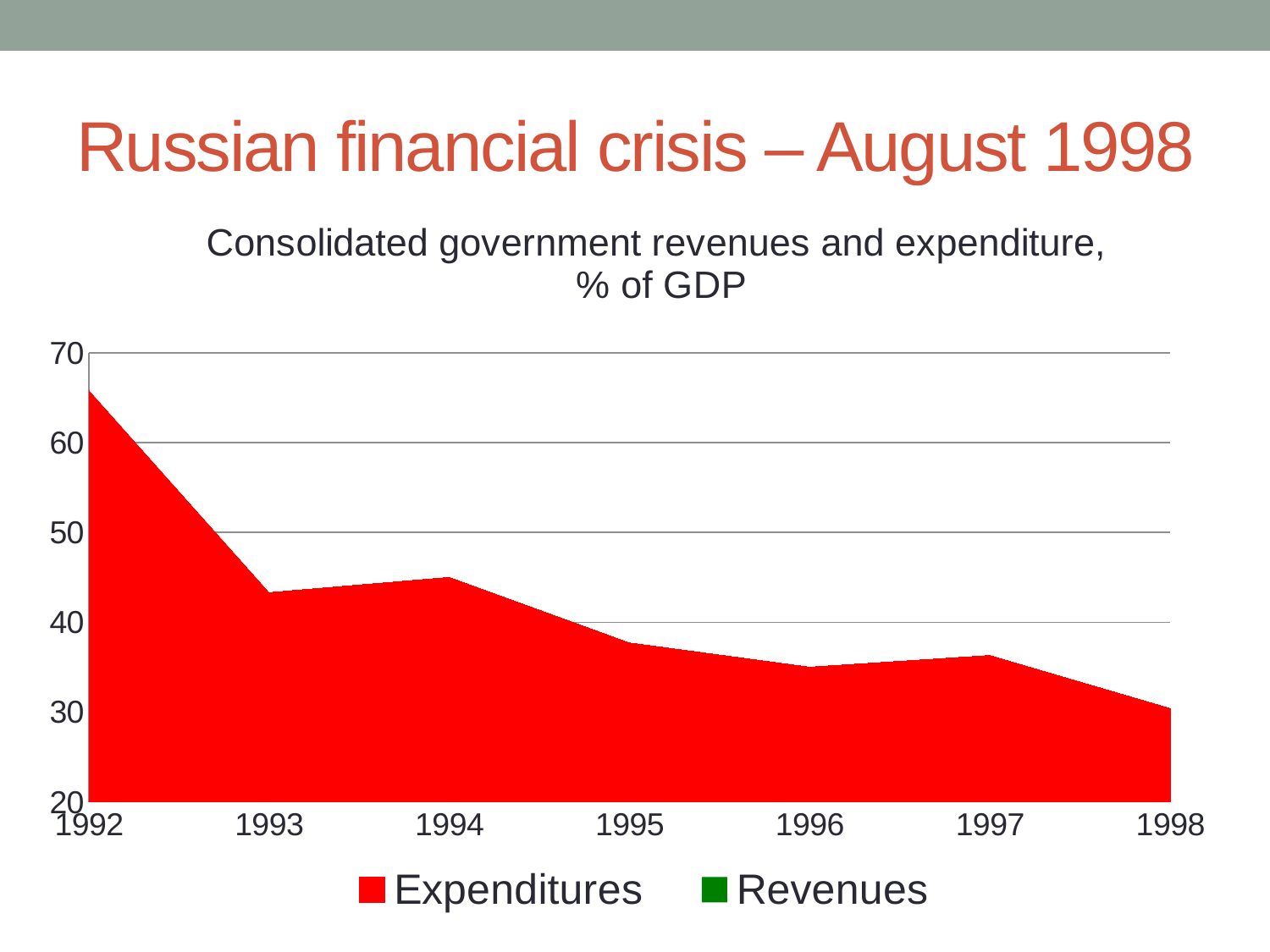
Is the Expenditures value for 1993 greater or less than 50? less What is the title of the chart? Consolidated government revenues and expenditure, % of GDP Is the Expenditures value for 1992 greater or less than 60? greater Is the Expenditures value for 1996 greater or less than 40? less In which year is the Expenditures value highest? 1992 In which year is the Expenditures value lowest? 1998 How many series does the legend list? 2 How many years are shown along the x axis? 7 What colour represents Expenditures in the legend? Red What kind of chart is shown on the slide? Area chart Which year has the larger Expenditures value, 1994 or 1997? 1994 Do Expenditures generally rise or fall from 1992 to 1998? Fall